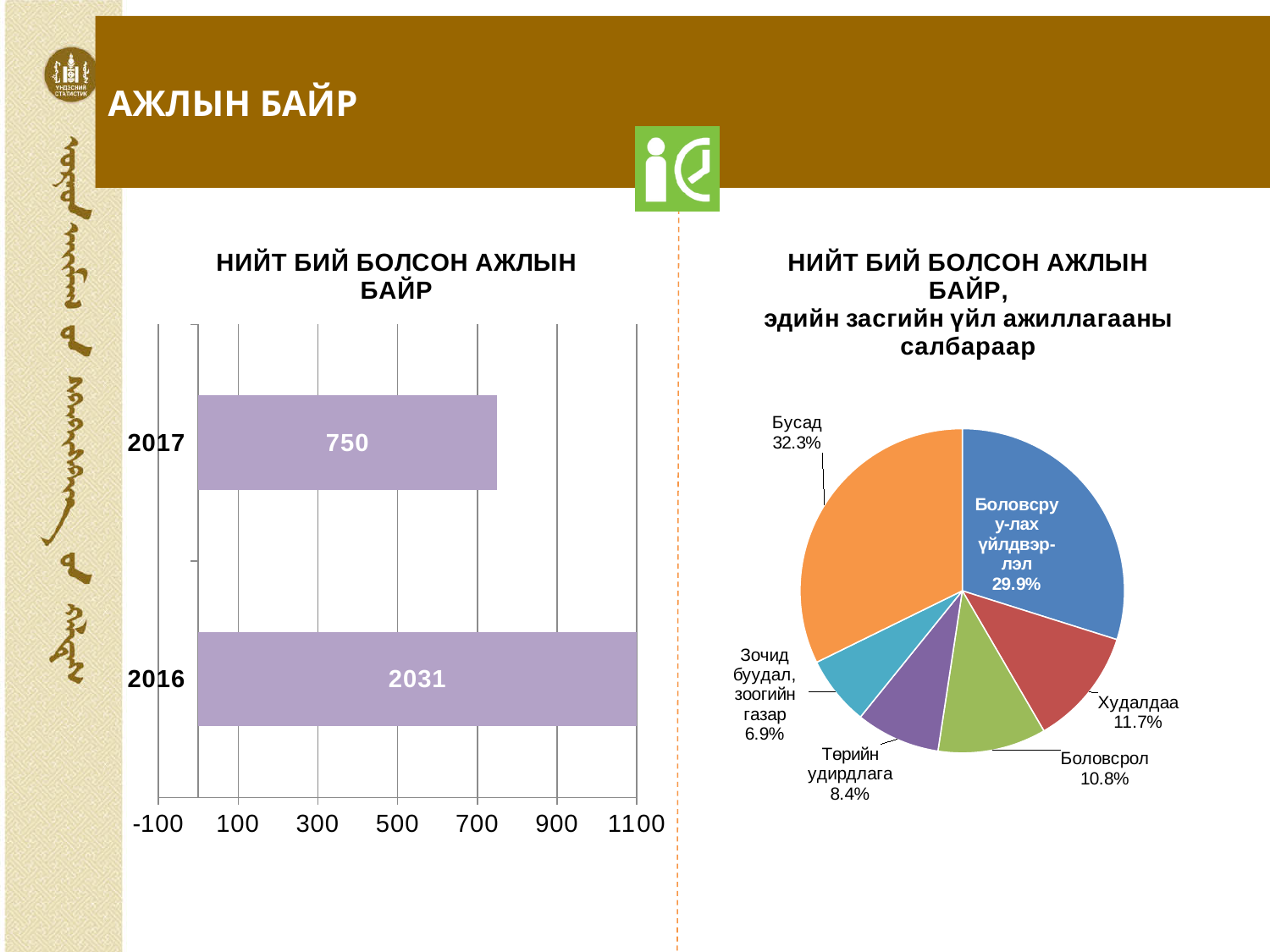
In the pie chart on the right, what share does Худалдаа have? 11.7% In the pie chart on the right, what share does Зочид буудал, зоогийн газар have? 6.9% In the bar chart on the left, what is the difference between the values for 2016 and 2017? 1281 In the bar chart on the left, what is the value for 2016? 2031 What kind of chart is the chart on the left of the slide? Bar chart In the pie chart on the right, which category has the largest share? Бусад In the pie chart on the right, what share does Боловсруулах үйлдвэрлэл have? 29.9% In the bar chart on the left, what is the value for 2017? 750 In the pie chart on the right, which category has the smallest share? Зочид буудал, зоогийн газар In the pie chart on the right, how many slices are there? 6 In the bar chart on the left, how many years are shown? 2 In the bar chart on the left, which year has the higher value, 2016 or 2017? 2016